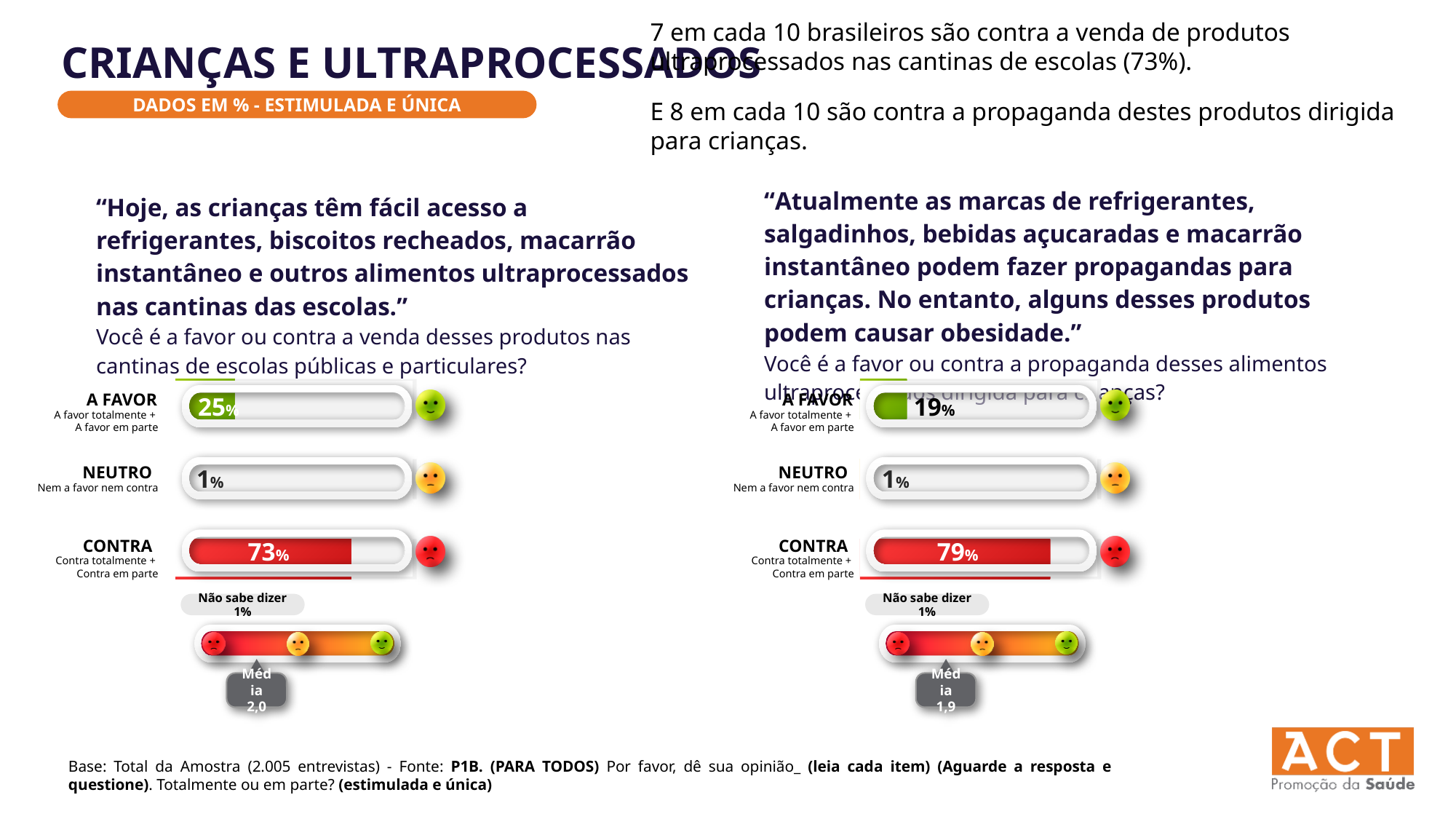
In the left chart (sale in school canteens), which category has the highest value? CONTRA In the left chart (sale in school canteens), what is the difference between CONTRA and A FAVOR? 48% In the right chart (advertising aimed at children), what is the value for CONTRA? 79% In the right chart (advertising aimed at children), what is the value for A FAVOR? 19% In the left chart (sale in school canteens), what is the value for A FAVOR? 25% In the right chart (advertising aimed at children), which category has the lowest value? NEUTRO Which chart has the larger CONTRA value, the left chart (sale in school canteens) or the right chart (advertising aimed at children)? the right chart In the right chart (advertising aimed at children), what is the value for NEUTRO? 1% In the left chart (sale in school canteens), what is the value for CONTRA? 73% What kind of chart is used on the left (sale in school canteens)? bar chart How many categories are shown as bars in the left chart (sale in school canteens)? 3 What is the Média (mean) shown below the right chart (advertising aimed at children)? 1,9